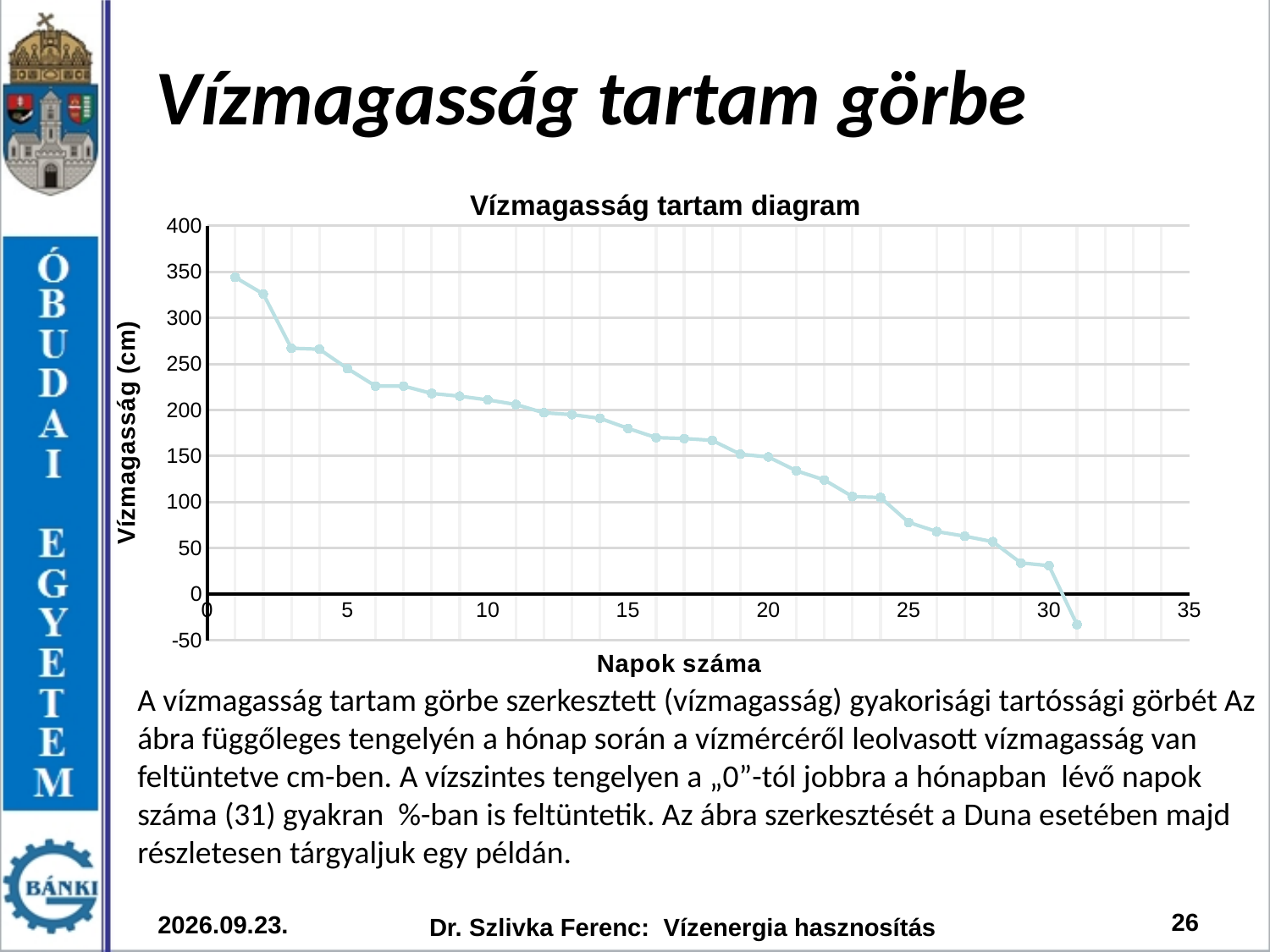
Which has the larger water level, day 5 or day 25? day 5 Do the values rise or fall as the number of days (Napok száma) increases? fall Is the value at day 5 greater or less than 200? greater What kind of chart is shown on the slide? line chart Is the value at day 25 greater or less than 100? less Is the value at day 20 greater or less than 200? less What is the title of the chart? Vízmagasság tartam diagram At which day number is the water level lowest? 31 At which day number is the water level highest? 1 What is the label of the vertical axis of the chart? Vízmagasság (cm)